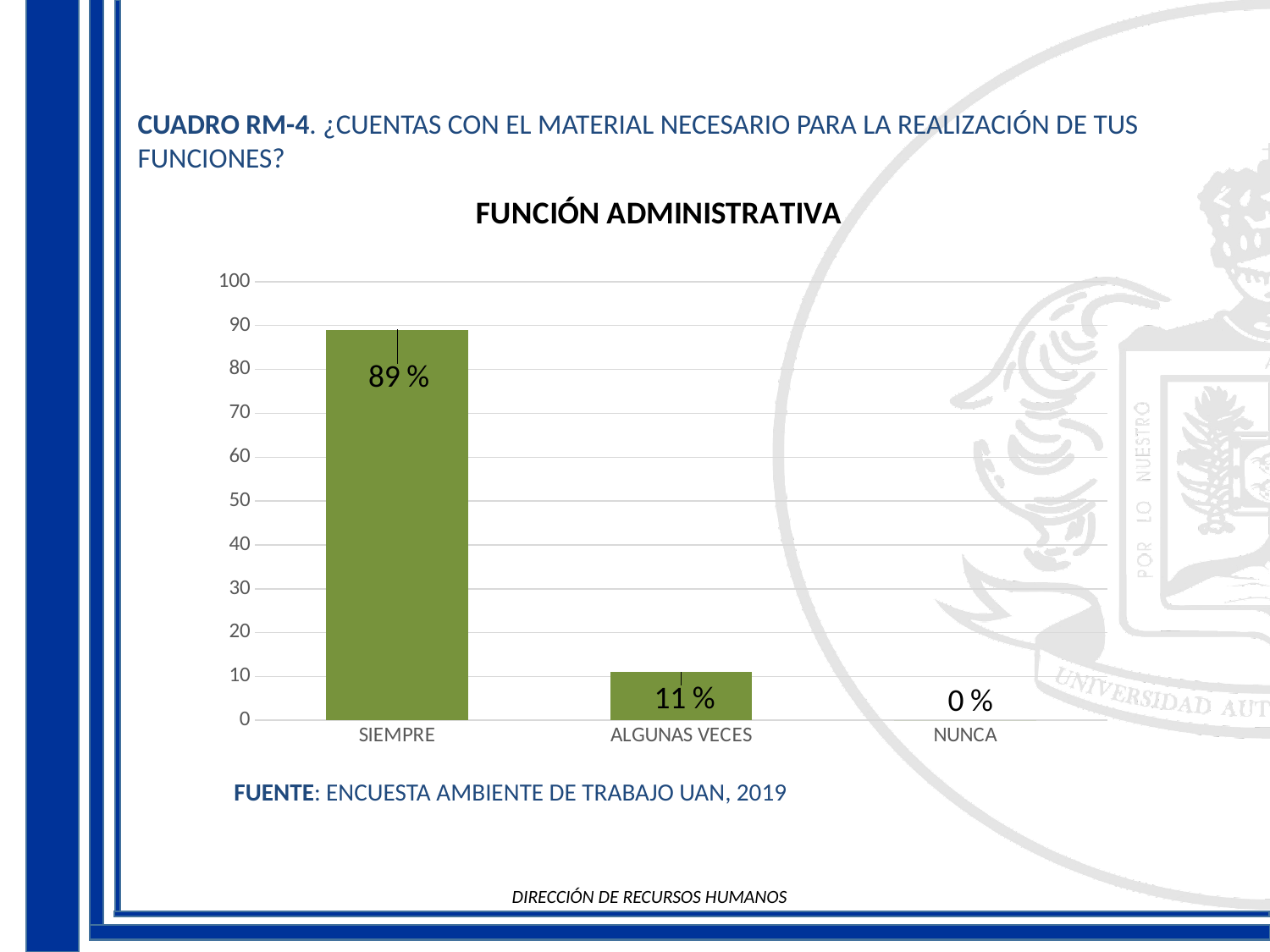
What is the value for NUNCA? 0 % What is the value for ALGUNAS VECES? 11 % How many categories are shown on the x axis? 3 Which is larger, the value for ALGUNAS VECES or the value for NUNCA? ALGUNAS VECES What is the value for SIEMPRE? 89 % What is the difference between the values for SIEMPRE and ALGUNAS VECES? 78 % Do the values rise or fall from left to right along the x axis? fall What is the title of the chart? FUNCIÓN ADMINISTRATIVA Is the value for SIEMPRE greater or less than 80? greater What kind of chart is shown? bar chart Which category has the highest value? SIEMPRE Which category has the lowest value? NUNCA